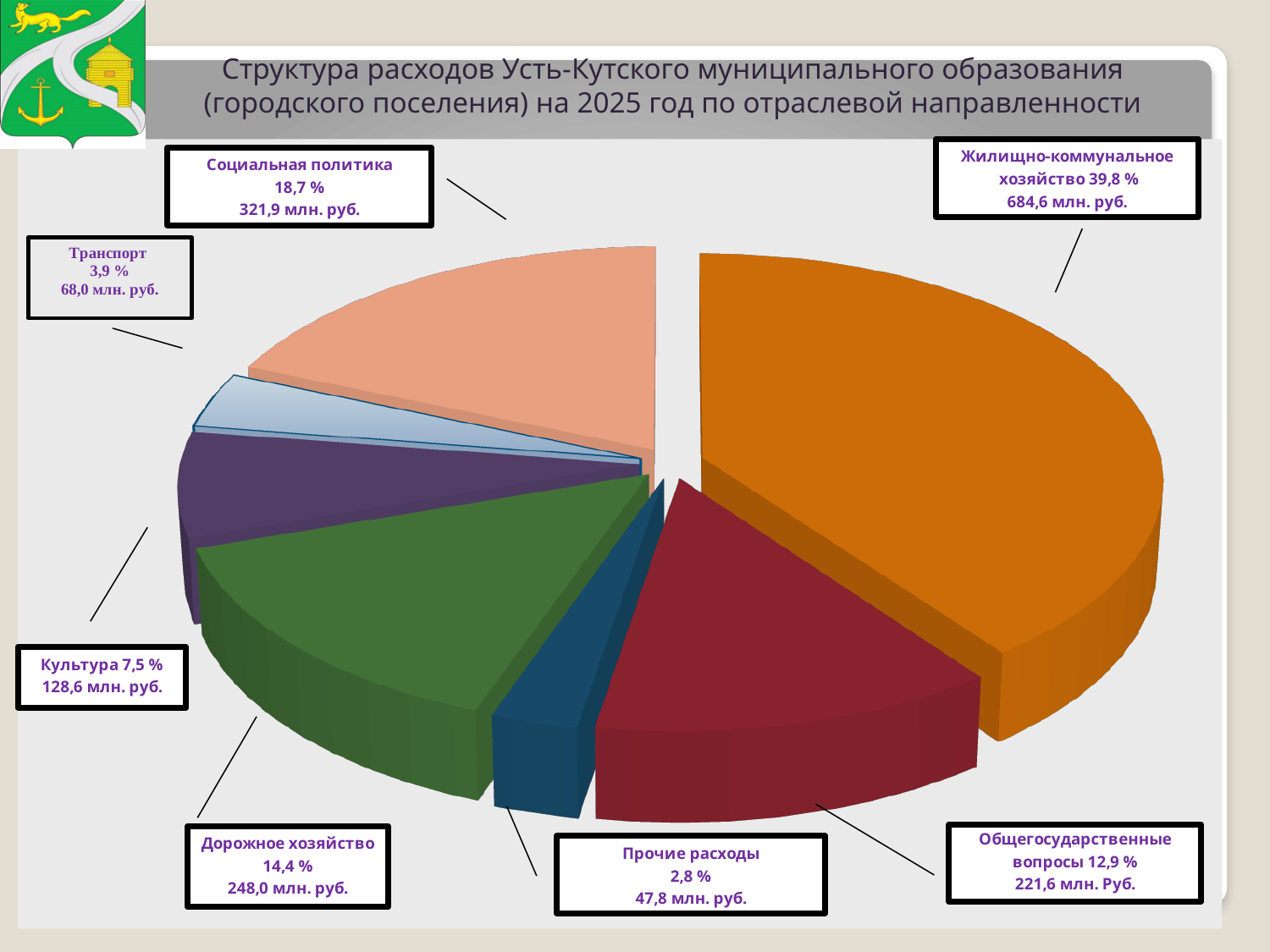
What percentage share is shown for Транспорт? 3,9 % How many slices (expenditure categories) does the pie chart have? 7 Which is larger: the amount for Дорожное хозяйство or for Общегосударственные вопросы? Дорожное хозяйство What is the amount in млн. руб. for Дорожное хозяйство? 248,0 млн. руб. What is the amount in млн. руб. for Социальная политика? 321,9 млн. руб. Which category has the smallest share of expenditures? Прочие расходы What kind of chart is shown on the slide? Pie chart What year does the chart title say the expenditure structure is for? 2025 What share of expenditures does Жилищно-коммунальное хозяйство account for? 39,8 % What is the amount in млн. руб. for Культура? 128,6 млн. руб. Which category has the largest share of expenditures? Жилищно-коммунальное хозяйство What is the difference in млн. руб. between Жилищно-коммунальное хозяйство and Социальная политика? 362,7 млн. руб.